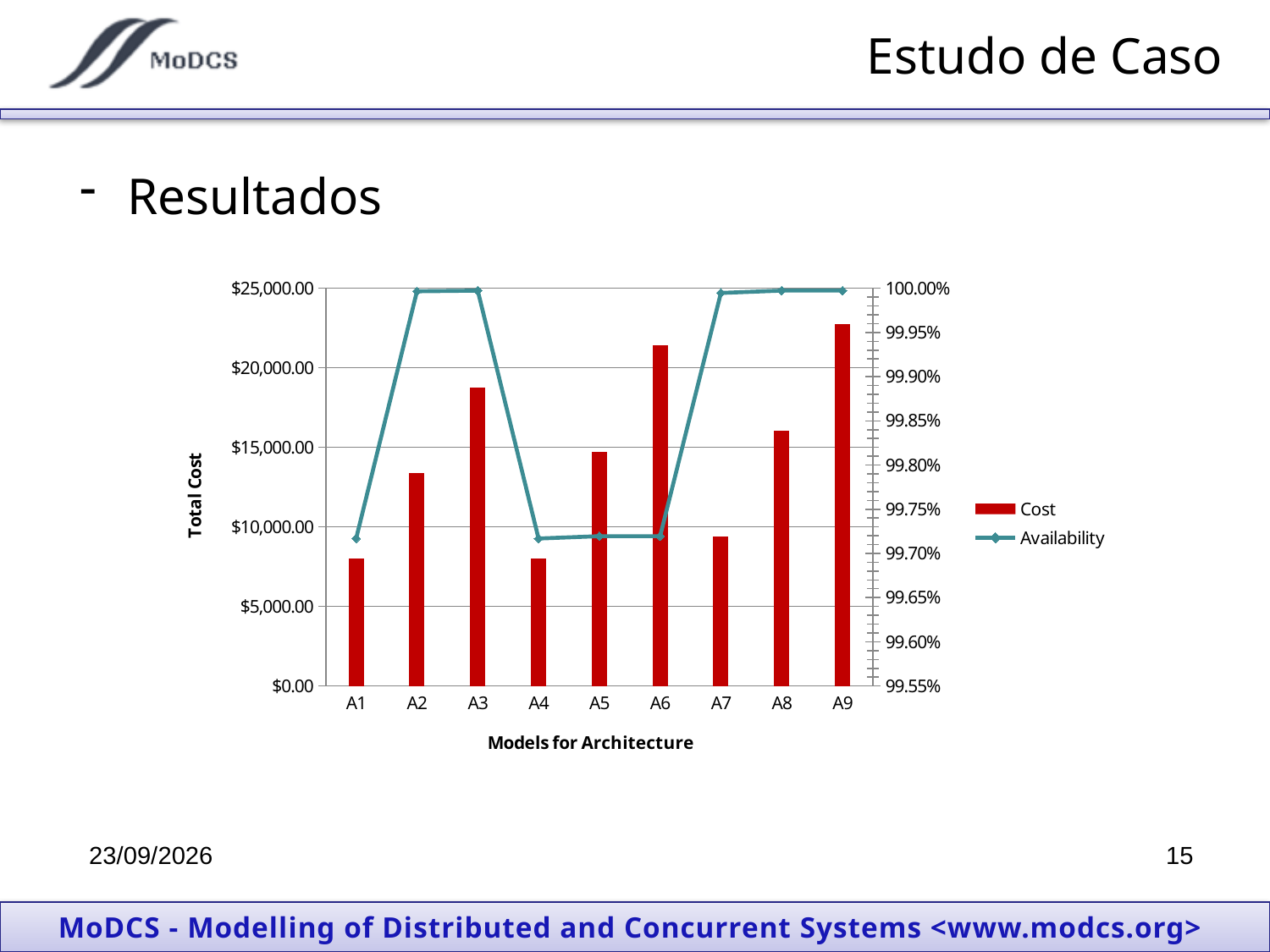
Is the Cost for A8 greater or less than $15,000.00? greater What is the title of the x axis of the chart? Models for Architecture Is the Cost for A6 greater or less than $20,000.00? greater How many series does the chart legend list? 2 Is the Availability for A4 greater or less than 99.75%? less Which series in the chart is drawn as bars? Cost Which has the higher Cost, A3 or A8? A3 Which architecture model has the highest Cost bar? A9 How many architecture models are shown on the x axis of the chart? 9